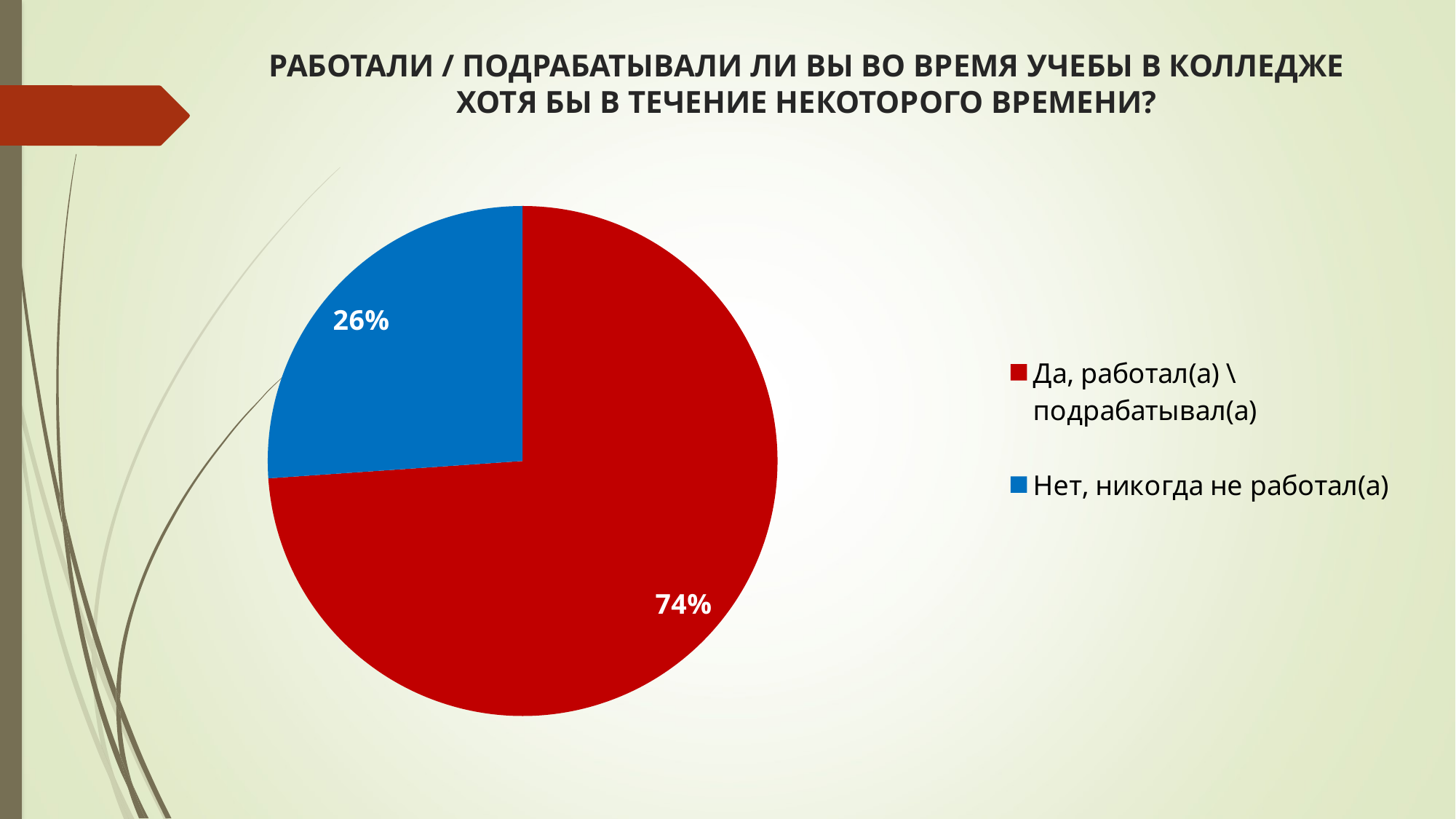
What kind of chart is shown on the slide? pie chart What is the difference in percentage points between the "Да" and "Нет" slices? 48 Which answer has the smallest share of the pie? Нет, никогда не работал(а) What colour is the slice for "Да, работал(а) \ подрабатывал(а)"? red Which answer has the largest share of the pie? Да, работал(а) \ подрабатывал(а) How many entries does the legend list? 2 Which is larger: the share for "Да, работал(а) \ подрабатывал(а)" or for "Нет, никогда не работал(а)"? Да, работал(а) \ подрабатывал(а) What share of respondents answered "Да, работал(а) \ подрабатывал(а)"? 74% How many slices does the pie chart have? 2 What is the total of the two slice percentages shown? 100% What colour is the slice for "Нет, никогда не работал(а)"? blue What share of respondents answered "Нет, никогда не работал(а)"? 26%